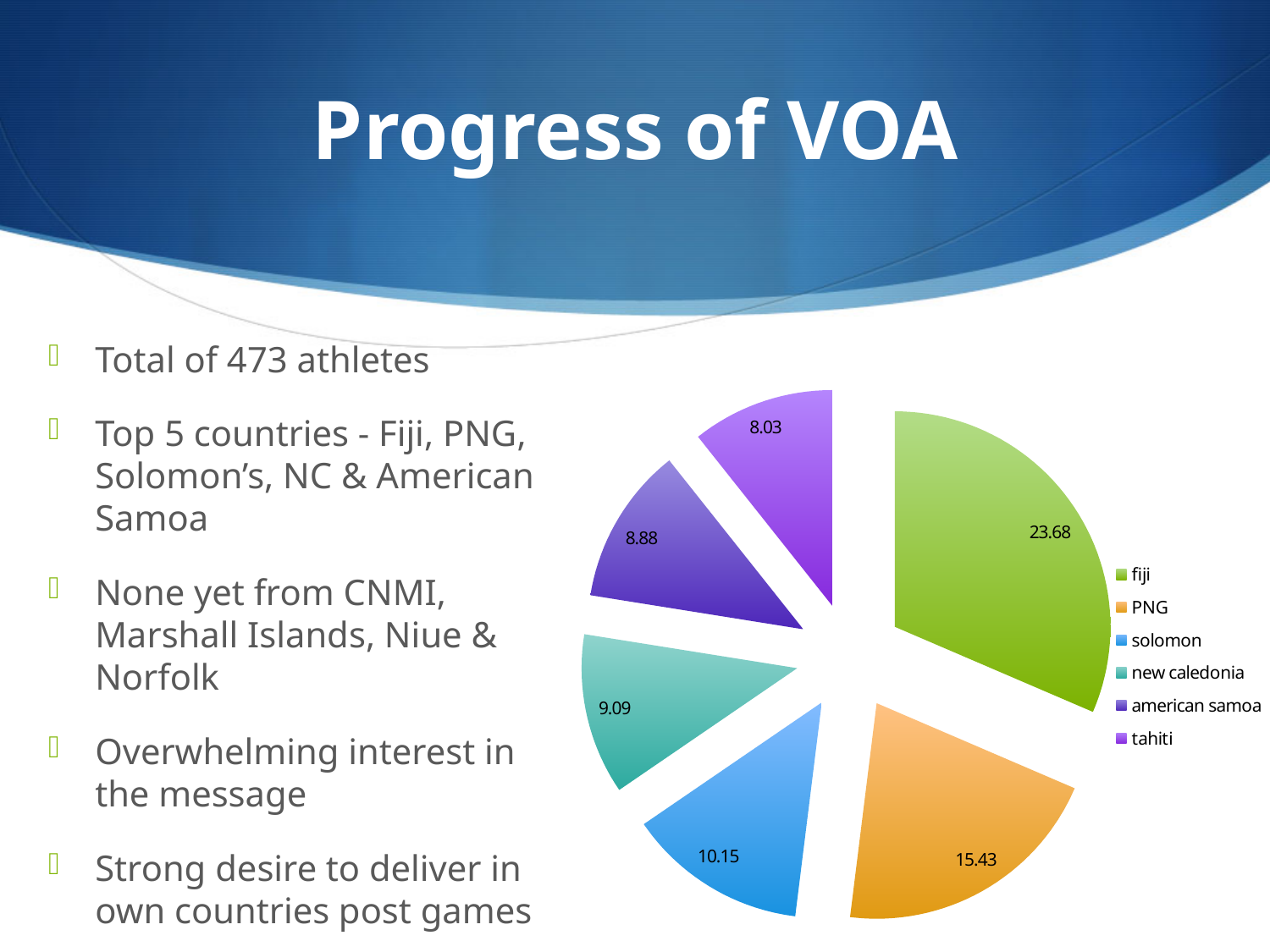
Which category has the smallest slice in the pie chart? tahiti What type of chart is shown on the slide? pie chart Which category has the largest slice in the pie chart? fiji What value is shown for the tahiti slice of the pie chart? 8.03 What value is shown for the PNG slice of the pie chart? 15.43 What colour is the fiji slice in the pie chart? green Which is larger in the pie chart, the value for american samoa or the value for tahiti? american samoa What value is shown for the fiji slice of the pie chart? 23.68 How many slices does the pie chart have? 6 What is the difference between the fiji value and the PNG value in the pie chart? 8.25 What value is shown for the solomon slice of the pie chart? 10.15 What value is shown for the new caledonia slice of the pie chart? 9.09